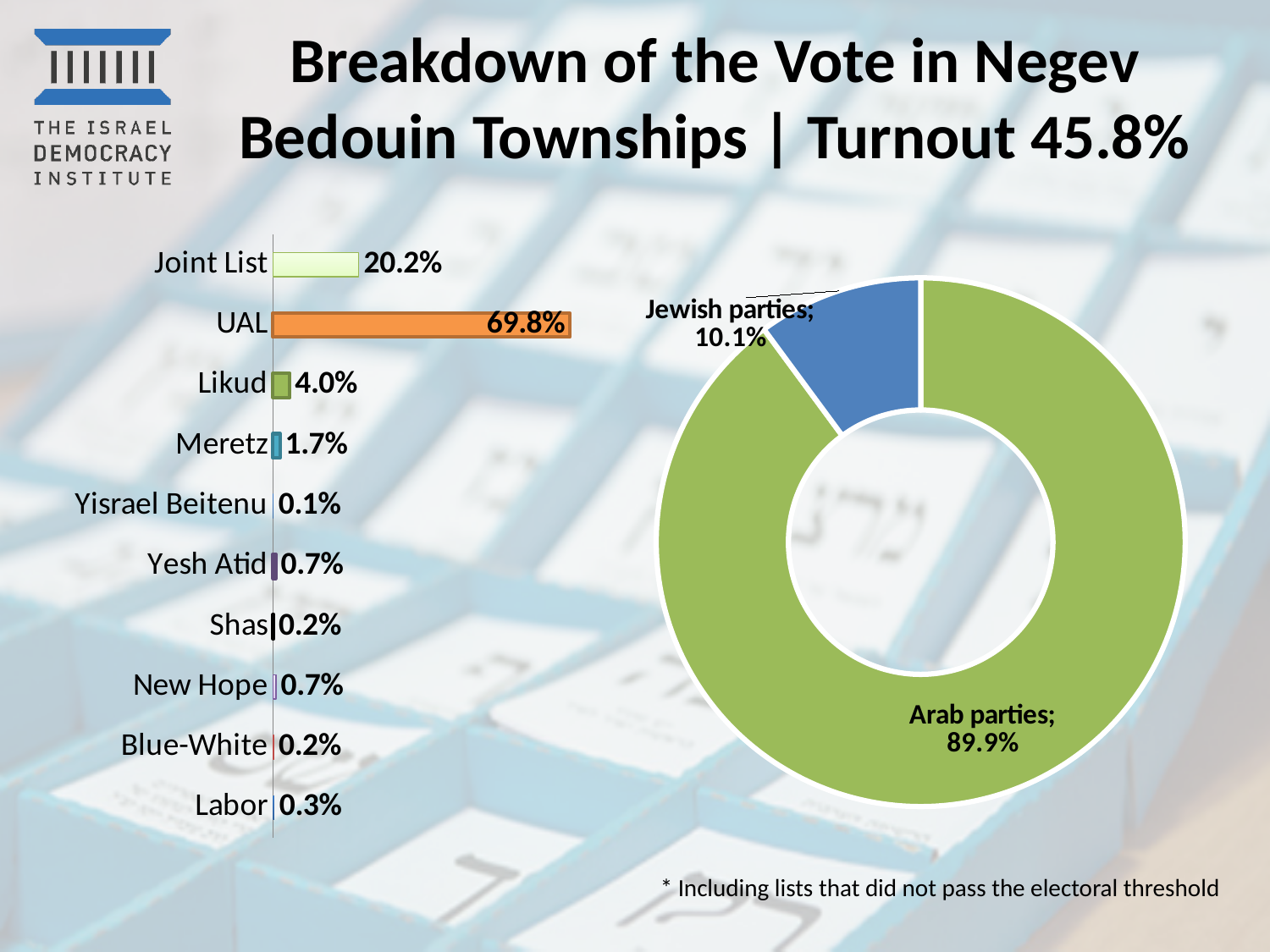
In the bar chart on the left, what is the difference between the UAL and Joint List shares? 49.6% What turnout figure is given in the slide title? 45.8% In the bar chart on the left, what is the value for Likud? 4.0% In the bar chart on the left, which party has the highest share of the vote? UAL In the donut chart on the right, which segment is larger, Arab parties or Jewish parties? Arab parties How many parties are listed in the bar chart on the left? 10 In the donut chart on the right, what share of the vote went to Jewish parties? 10.1% In the bar chart on the left, which is larger, the value for Meretz or the value for Likud? Likud In the donut chart on the right, what share of the vote went to Arab parties? 89.9% In the bar chart on the left, what percentage of the vote did the Joint List receive? 20.2% In the bar chart on the left, what percentage of the vote did UAL receive? 69.8% What type of chart is shown on the left side of the slide? Bar chart